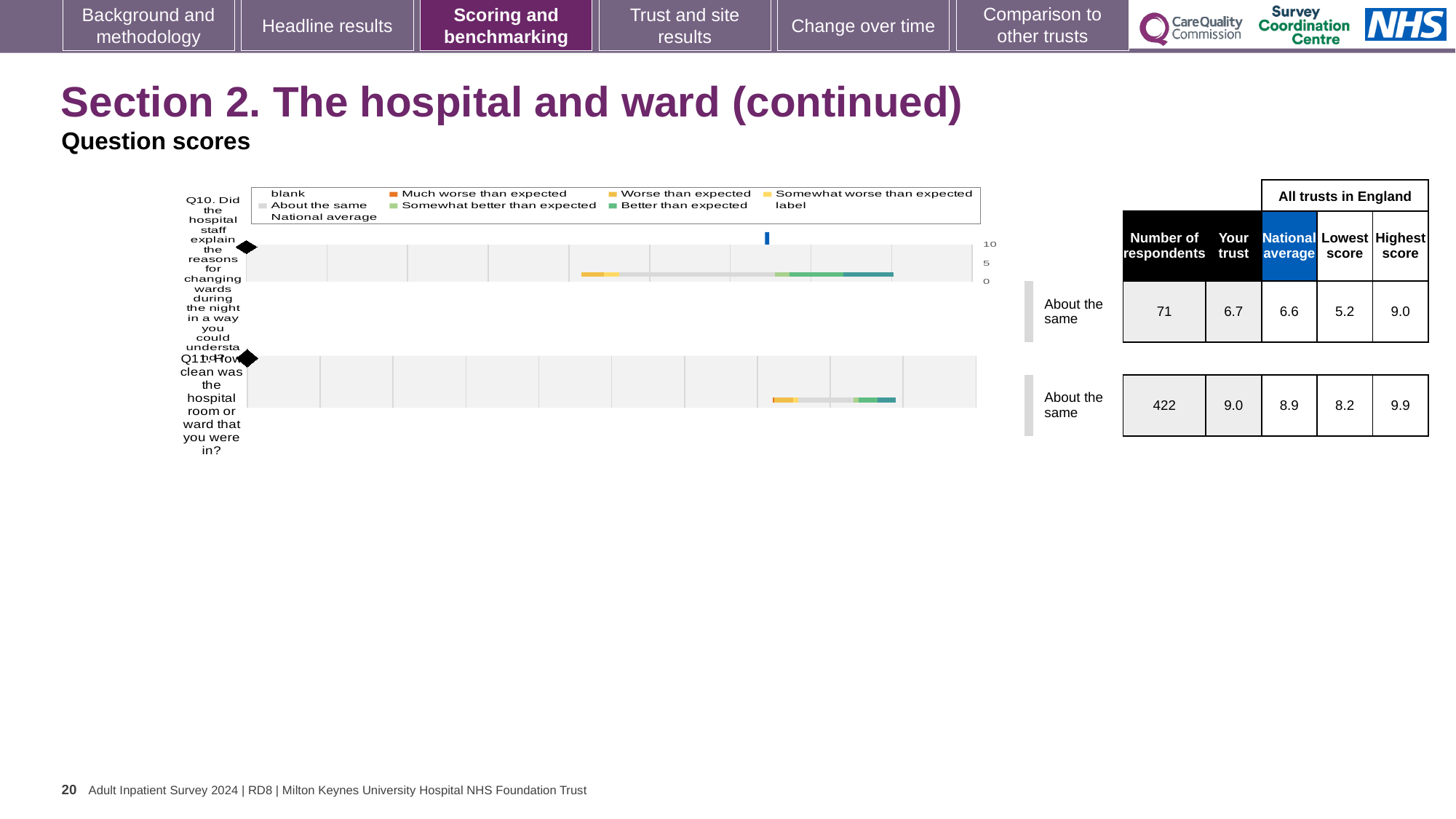
What is the national average score for Q10? 6.6 How many questions are plotted on the slide? 2 What is the maximum value shown on the score axis of the chart? 10 What benchmark category is shown for Q10? About the same What is the number of respondents for Q10? 71 For Q11, which is larger: the 'Your trust' score or the national average? Your trust What is the highest score among all trusts in England for Q11? 9.9 What is the difference between the highest and lowest scores for Q11? 1.7 Which question has the larger number of respondents, Q10 or Q11? Q11 What kind of chart is used to show the question scores for Q10 and Q11? bar chart What is the lowest score among all trusts in England for Q10? 5.2 What is the 'Your trust' score for Q11 (how clean was the hospital room or ward)? 9.0